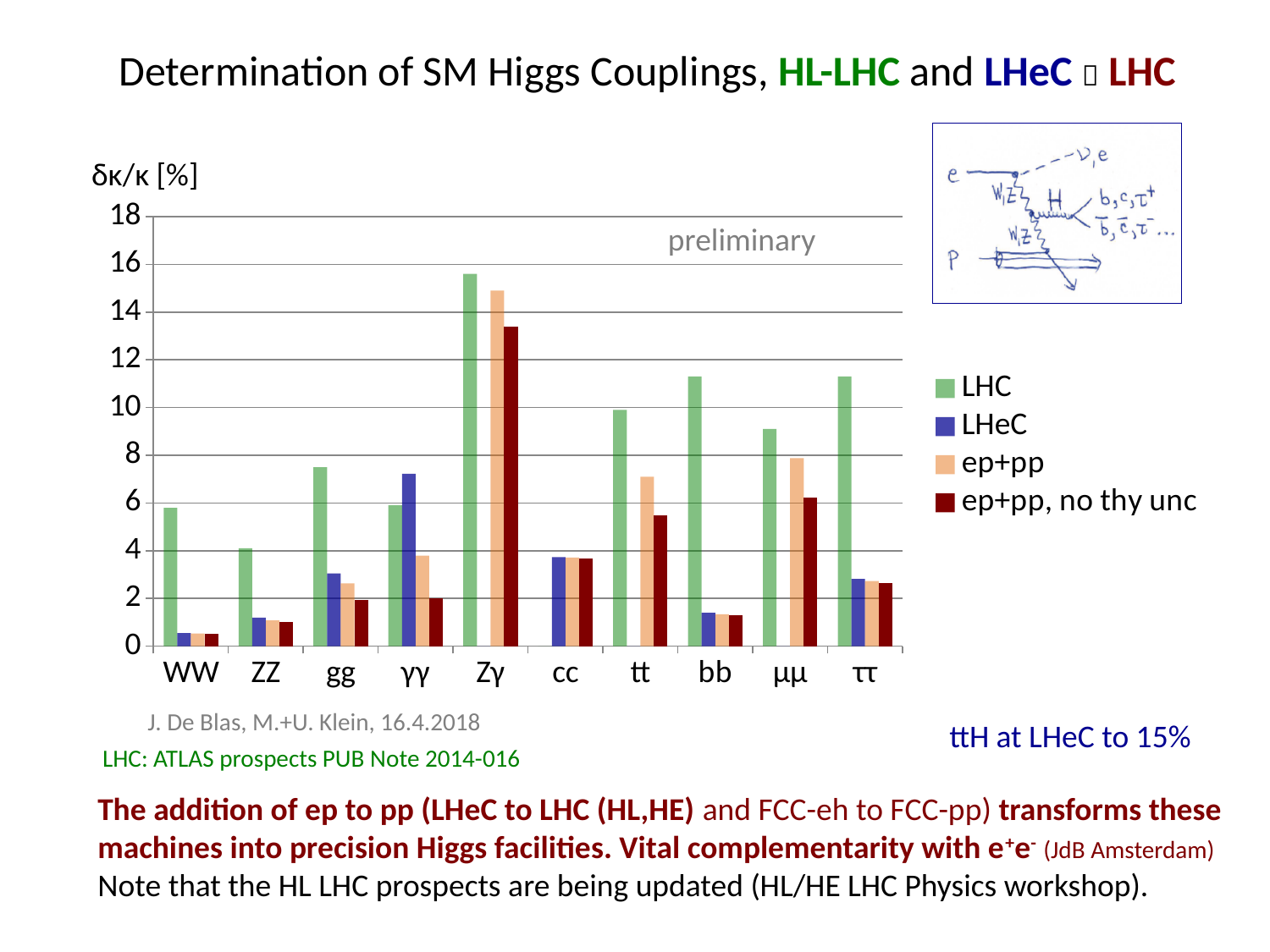
Is the ep+pp value for tt greater or less than 6? greater Which is larger for γγ, the LHC value or the LHeC value? LHeC How many series does the chart's legend list? 4 What is the label on the vertical axis of the chart? δκ/κ [%] Is the LHC value for bb greater or less than 10? greater For which category is the LHC series highest? Zγ How many categories are shown along the x axis of the chart? 10 Is the LHC value for Zγ greater or less than 14? greater What kind of chart is shown on the slide? bar chart Which is larger for the LHC series, the value for Zγ or the value for WW? Zγ